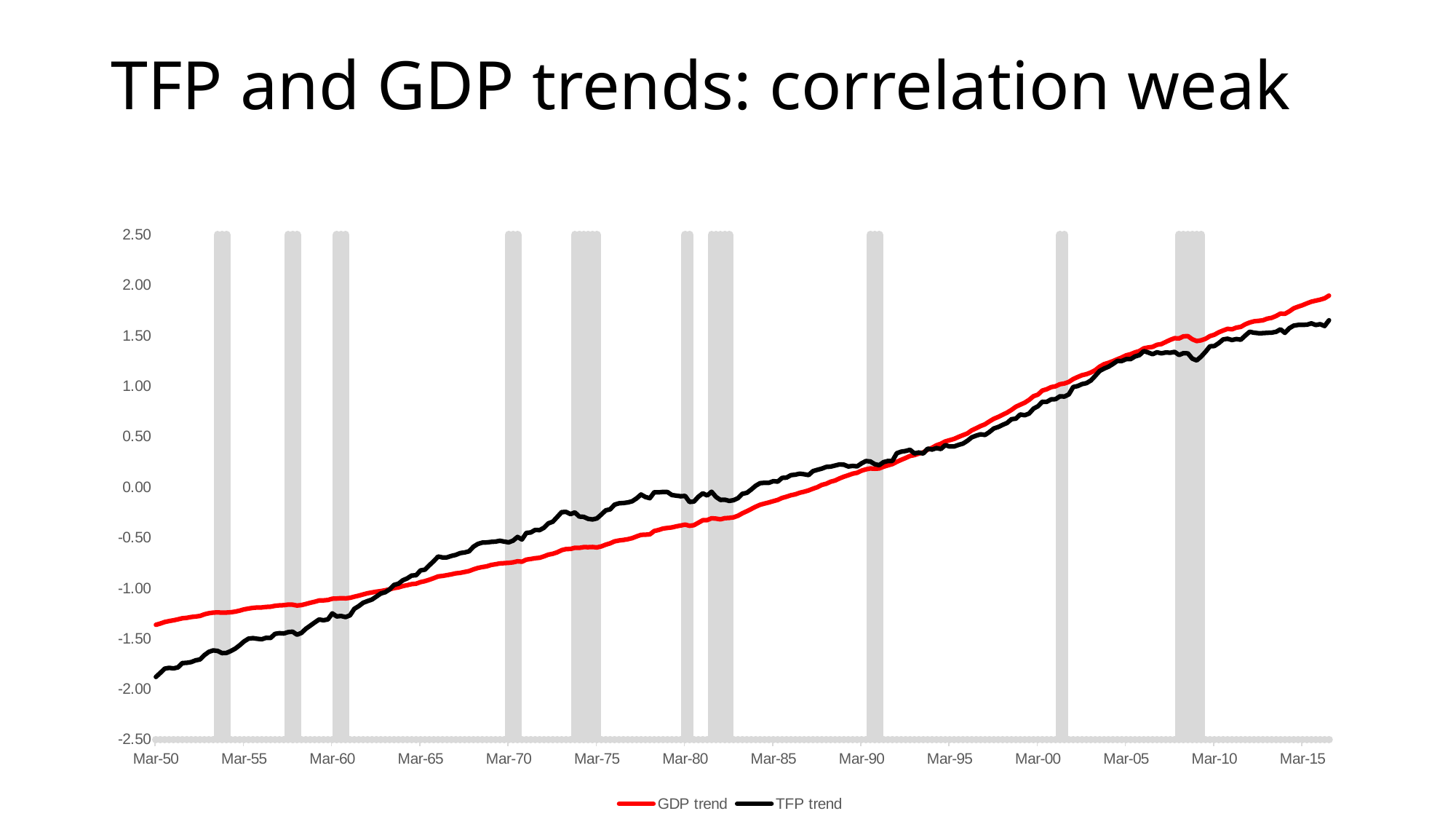
Is the TFP trend value at Mar-50 greater or less than -1.50? less How many series does the legend list? 2 Is the GDP trend value at Mar-80 greater or less than 0.00? less Is the GDP trend value at Mar-15 greater or less than 1.50? greater Which colour is used for the TFP trend line? black At Mar-50, which series has the higher value, GDP trend or TFP trend? GDP trend What kind of chart is shown on the slide? line chart What is the title of the slide? TFP and GDP trends: correlation weak Do the TFP trend values rise or fall from Mar-50 to Mar-15? rise Do the GDP trend values rise or fall from Mar-50 to Mar-15? rise At Mar-80, which series has the higher value, GDP trend or TFP trend? TFP trend